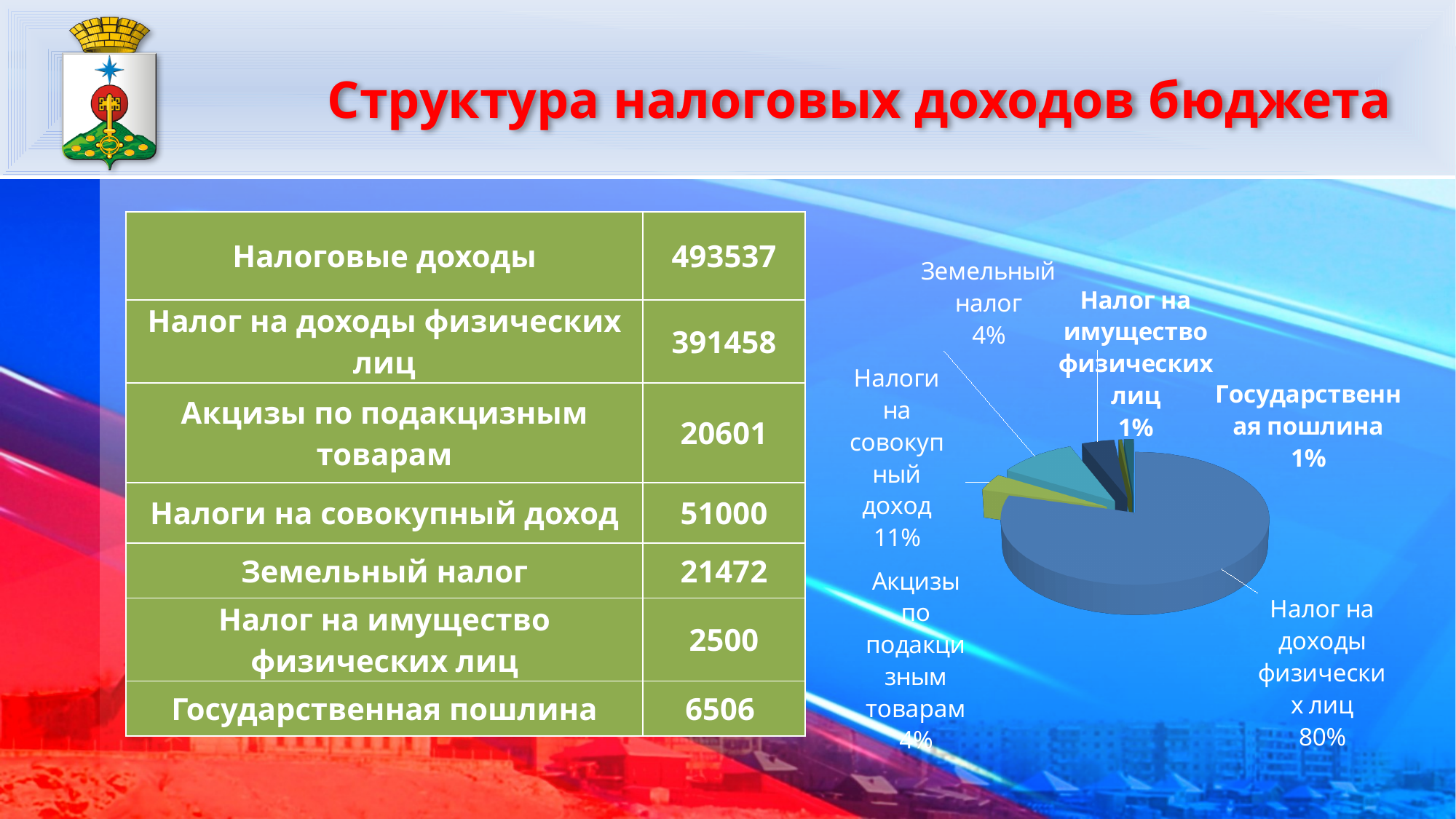
What share of the pie chart does "Налоги на совокупный доход" represent? 11% What share of the pie chart does "Налог на имущество физических лиц" represent? 1% What share of the pie chart does "Налог на доходы физических лиц" represent? 80% How many slices does the pie chart have? 6 Which slice of the pie chart is the largest? Налог на доходы физических лиц What kind of chart is shown on the right side of the slide? pie chart In the pie chart, which is larger: "Налоги на совокупный доход" or "Земельный налог"? Налоги на совокупный доход What is the title of the slide containing the pie chart? Структура налоговых доходов бюджета In the pie chart, what is the difference in percentage points between "Налог на доходы физических лиц" and "Налоги на совокупный доход"? 69 percentage points